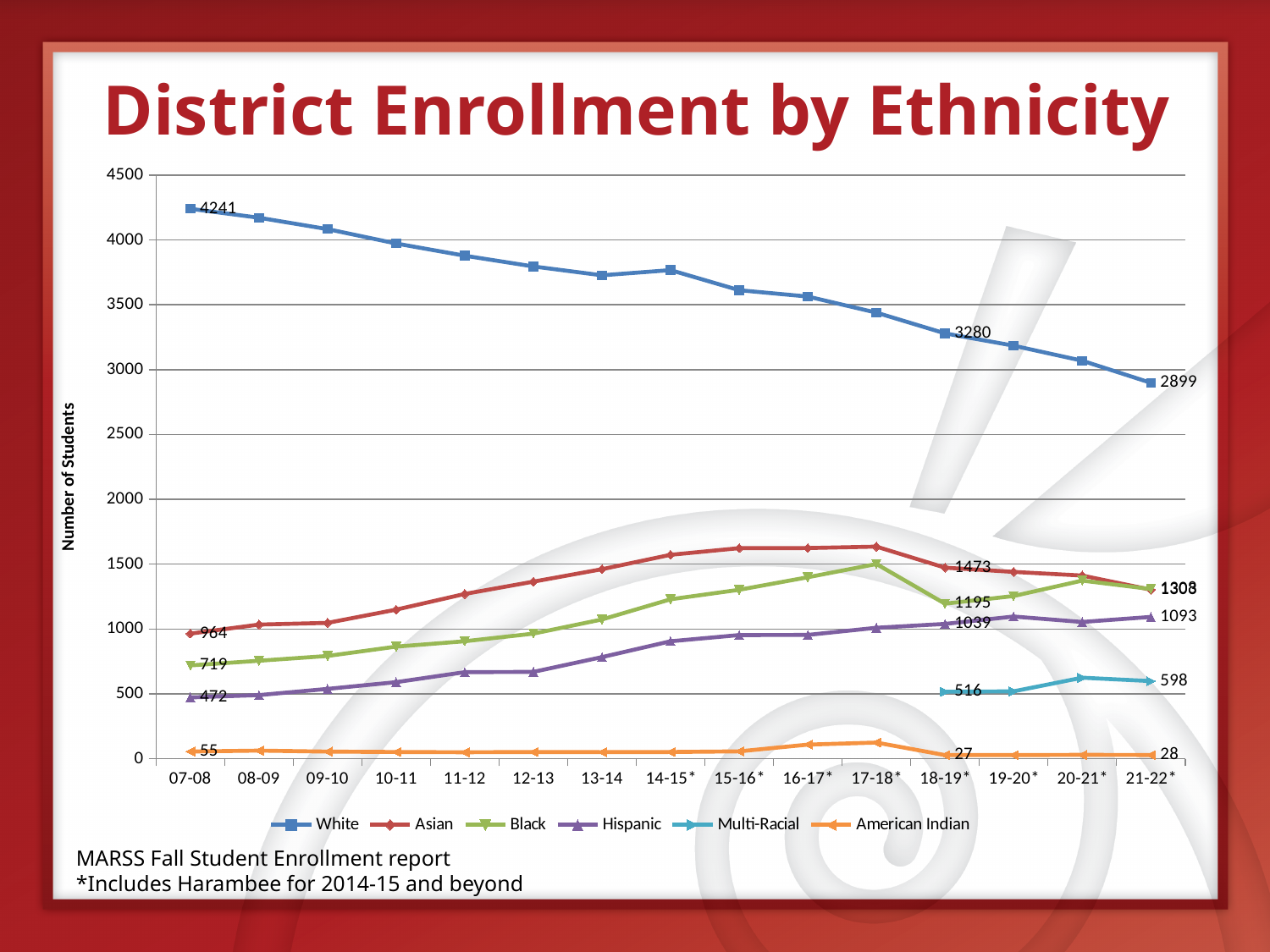
Does the White enrollment line rise or fall from 07-08 to 21-22*? fall How many school years are shown on the x axis? 15 What was the Multi-Racial enrollment in 21-22*? 598 How much higher was Asian enrollment in 18-19* than in 07-08? 509 Which ethnicity had the lowest enrollment in 21-22*? American Indian By how much did White enrollment fall from 07-08 to 21-22*? 1342 What kind of chart is shown on the slide? line chart What was the Hispanic enrollment in 18-19*? 1039 What was the White enrollment in 21-22*? 2899 How many series does the legend list? 6 Is the White enrollment in 12-13 greater or less than 3500? greater What was the White enrollment in 07-08? 4241